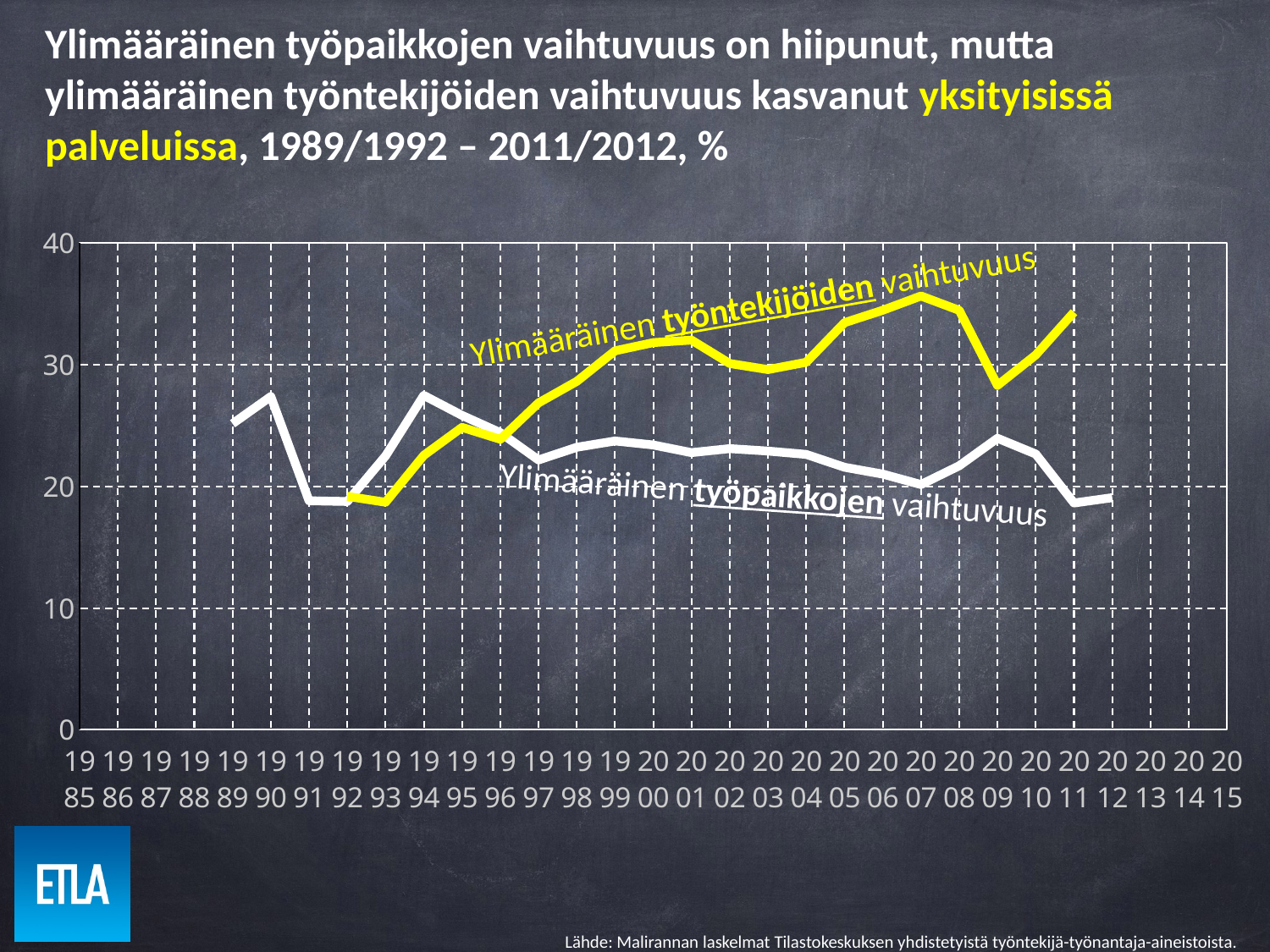
Is the value of Ylimääräinen työntekijöiden vaihtuvuus in 1993 greater or less than 20? less Is the value of Ylimääräinen työpaikkojen vaihtuvuus in 2012 greater or less than 20? less Is the value of Ylimääräinen työntekijöiden vaihtuvuus in 2009 greater or less than 30? less Does Ylimääräinen työntekijöiden vaihtuvuus rise or fall between 1993 and 2001? rise For Ylimääräinen työpaikkojen vaihtuvuus, which year has the larger value: 1990 or 1991? 1990 What kind of chart is shown on the slide? line chart Does Ylimääräinen työpaikkojen vaihtuvuus rise or fall between 1999 and 2007? fall How many data series are plotted on the chart? 2 In 2007, which series has the higher value: Ylimääräinen työntekijöiden vaihtuvuus or Ylimääräinen työpaikkojen vaihtuvuus? Ylimääräinen työntekijöiden vaihtuvuus What colour is the line for Ylimääräinen työntekijöiden vaihtuvuus? yellow